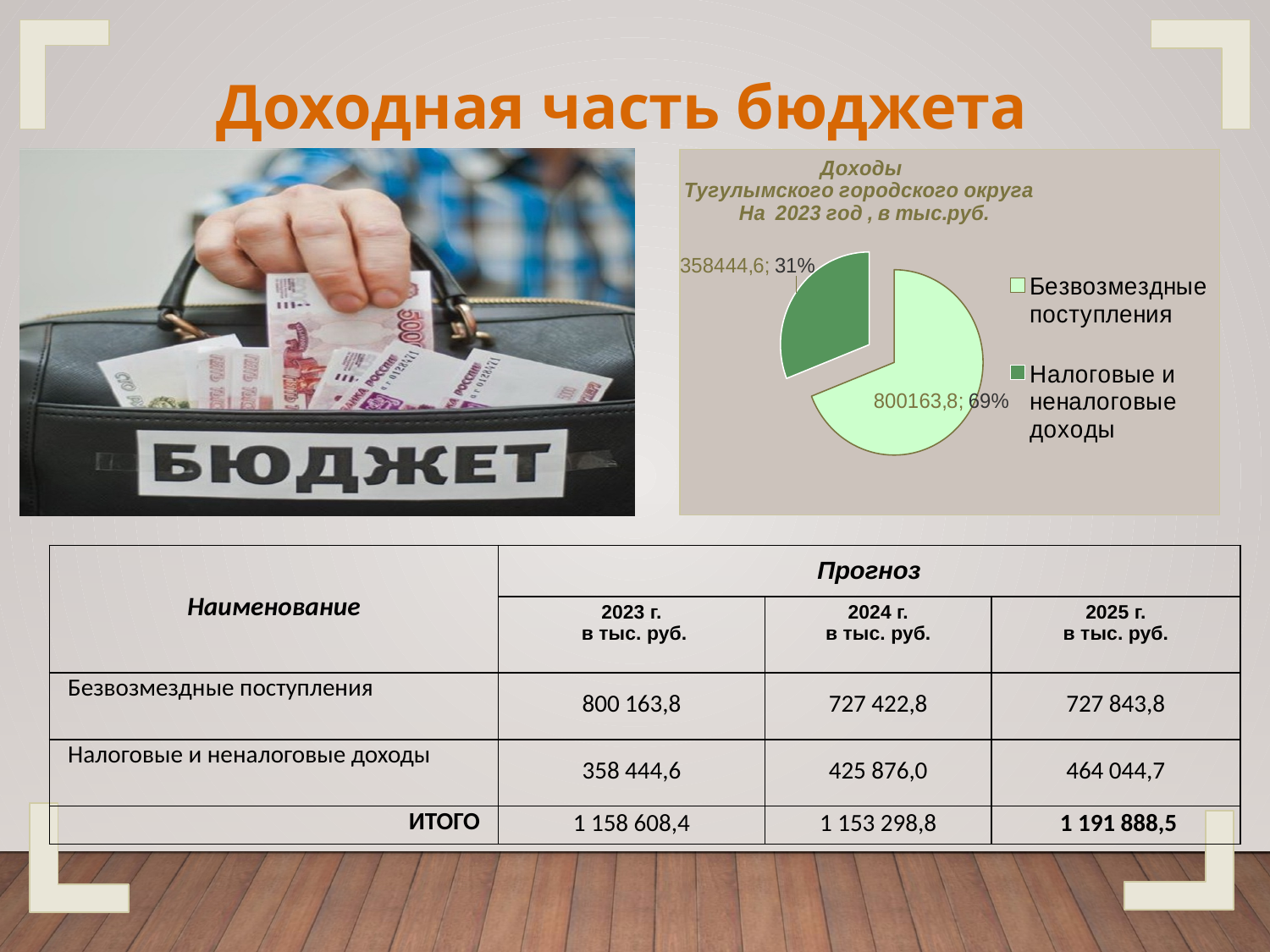
Which slice of the pie chart is the smallest? Налоговые и неналоговые доходы What is the difference between the values for Безвозмездные поступления and Налоговые и неналоговые доходы in the pie chart? 441719,2 What kind of chart is shown on the slide? pie chart Which slice of the pie chart is the largest? Безвозмездные поступления In the pie chart, what is the value for Налоговые и неналоговые доходы? 358444,6 How many slices does the pie chart have? 2 What share of the pie does Налоговые и неналоговые доходы take? 31% What colour is the Налоговые и неналоговые доходы slice in the pie chart? dark green In the pie chart, what is the value for Безвозмездные поступления? 800163,8 How many entries does the pie chart's legend list? 2 Which is larger in the pie chart: Безвозмездные поступления or Налоговые и неналоговые доходы? Безвозмездные поступления What share of the pie does Безвозмездные поступления take? 69%